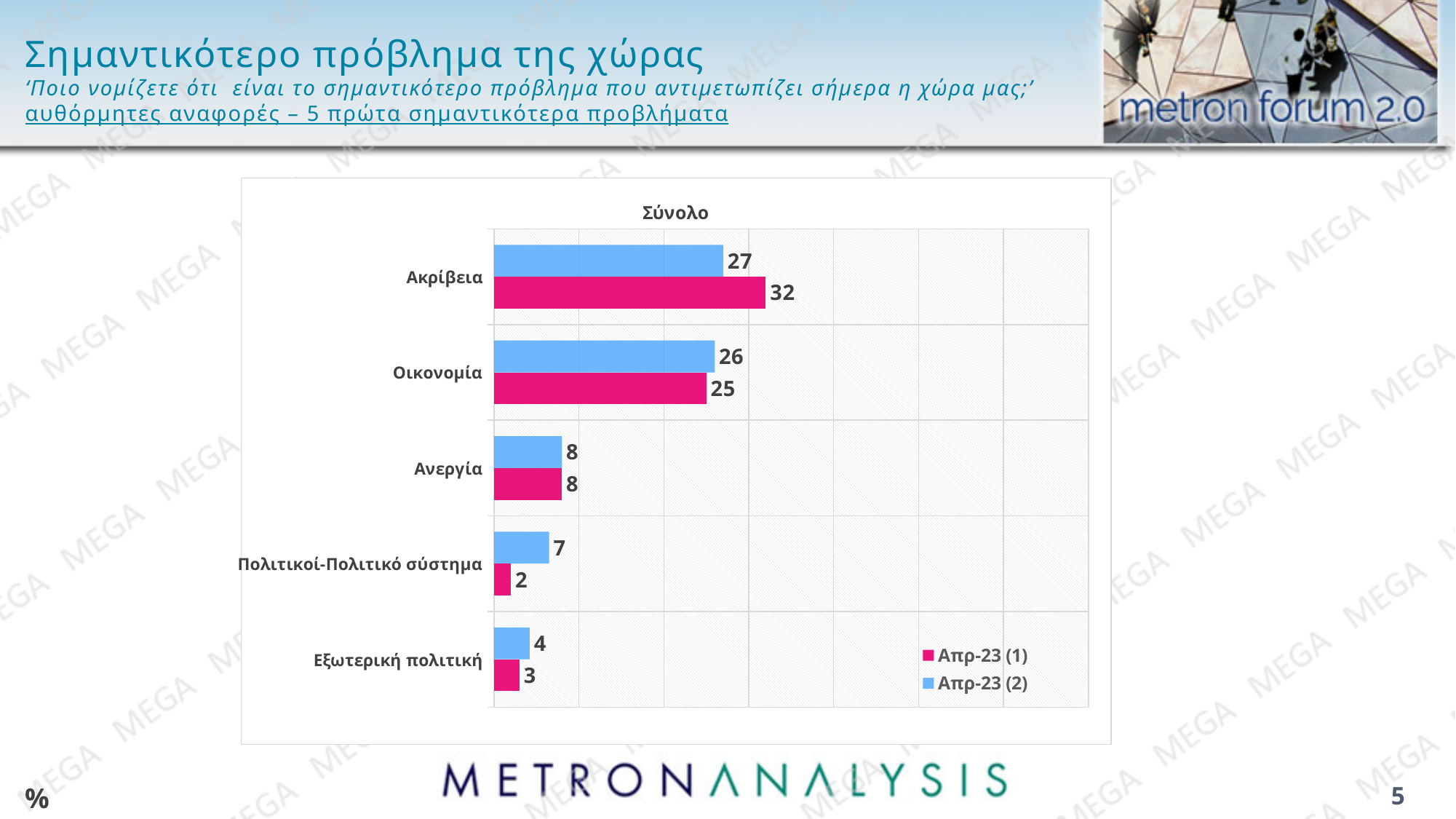
Which is larger for Οικονομία: the Απρ-23 (1) value or the Απρ-23 (2) value? Απρ-23 (2) Which category has the highest value in the Απρ-23 (2) series? Ακρίβεια What is the value for Ακρίβεια in the Απρ-23 (1) series? 32 What is the value for Οικονομία in the Απρ-23 (2) series? 26 What is the value for Πολιτικοί-Πολιτικό σύστημα in the Απρ-23 (1) series? 2 What is the difference between the Απρ-23 (2) and Απρ-23 (1) values for Πολιτικοί-Πολιτικό σύστημα? 5 What is the title of the chart? Σύνολο How many series does the legend list? 2 What is the difference between the Απρ-23 (1) and Απρ-23 (2) values for Ακρίβεια? 5 How many categories are shown on the chart? 5 Which category has the lowest value in the Απρ-23 (1) series? Πολιτικοί-Πολιτικό σύστημα What kind of chart is shown on the slide? Bar chart